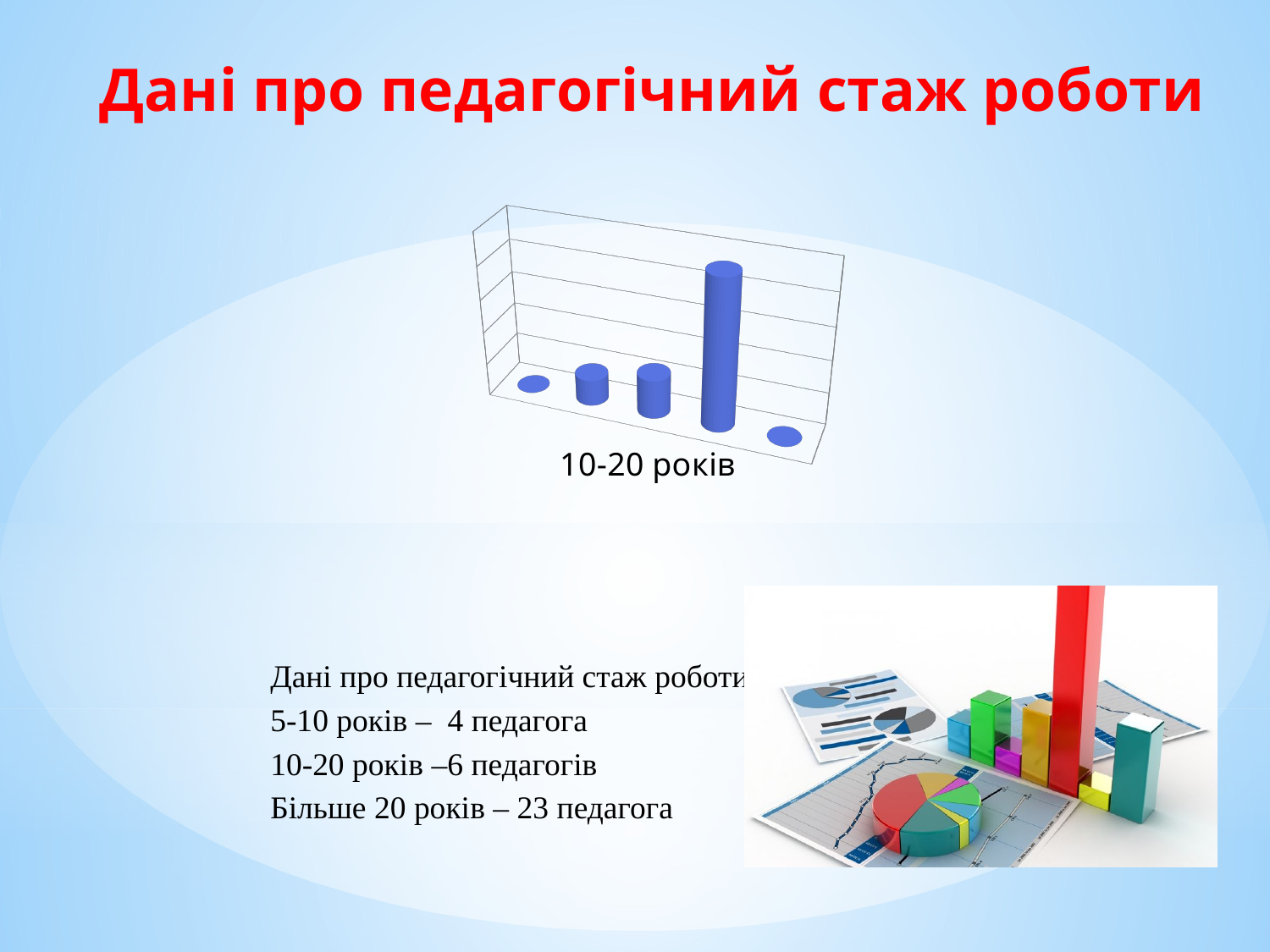
What kind of chart is shown on the slide? bar chart What category label is printed beneath the chart? 10-20 років Is the fourth bar from the left taller or shorter than the second bar? taller Which bar in the chart is the tallest, counting from the left? the fourth bar What colour are the bars in the chart? blue